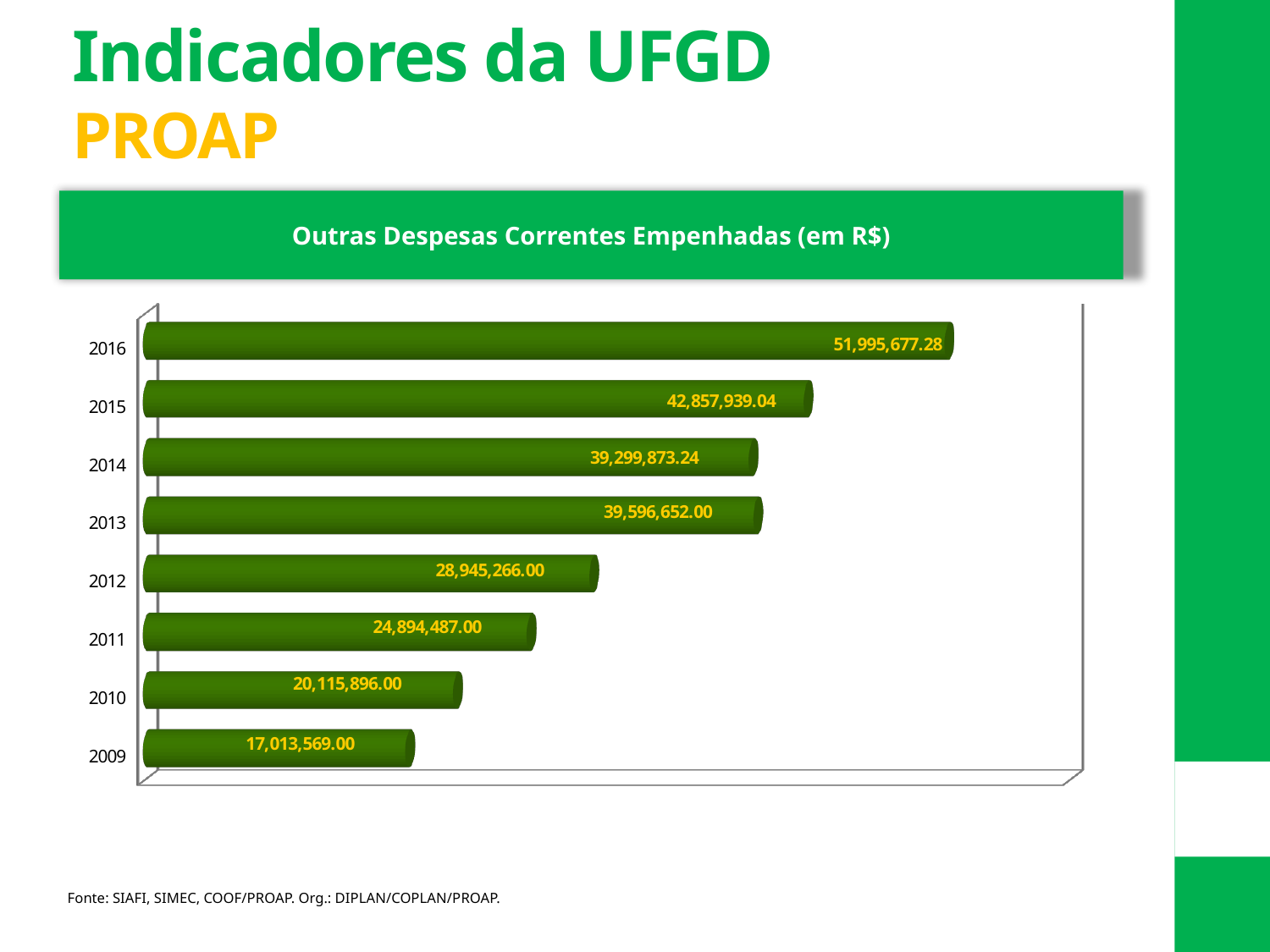
How many years are shown in the chart? 8 What is the title of the chart? Outras Despesas Correntes Empenhadas (em R$) What is the value for 2012 in the chart? 28,945,266.00 What is the value for 2016 in the chart? 51,995,677.28 What is the difference between the values for 2016 and 2015? 9,137,738.24 What is the difference between the values for 2010 and 2009? 3,102,327.00 What is the value for 2014 in the chart? 39,299,873.24 What is the value for 2009 in the chart? 17,013,569.00 Which year has the lowest value in the chart? 2009 Which year has the larger value, 2013 or 2014? 2013 What kind of chart is shown on the slide? Bar chart Which year has the highest value in the chart? 2016